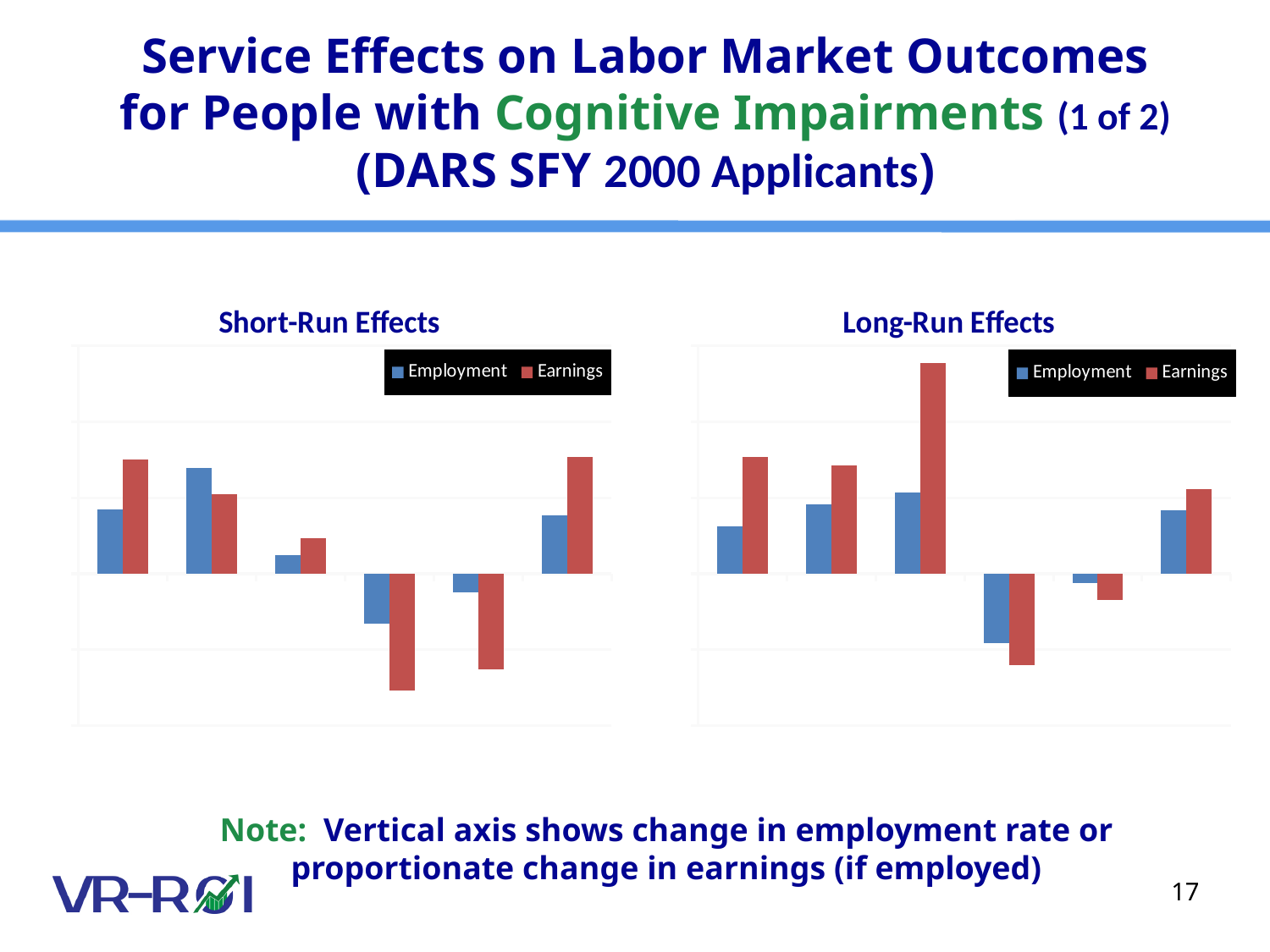
In the Short-Run Effects chart, which series contains the bar that extends furthest below zero? Earnings In the Long-Run Effects chart, how many bars extend below zero? 4 How many series does the legend of the Short-Run Effects chart list? 2 In the Short-Run Effects chart, how many bars extend below zero? 4 How many groups of bars are plotted in the Long-Run Effects chart? 6 In the Long-Run Effects chart, which series contains the tallest bar? Earnings What kind of chart is the Long-Run Effects chart? bar chart What are the two series named in the legend of the Long-Run Effects chart? Employment and Earnings What kind of chart is the Short-Run Effects chart? bar chart How many series does the legend of the Long-Run Effects chart list? 2 In the Short-Run Effects chart, which colour represents the Earnings series? red